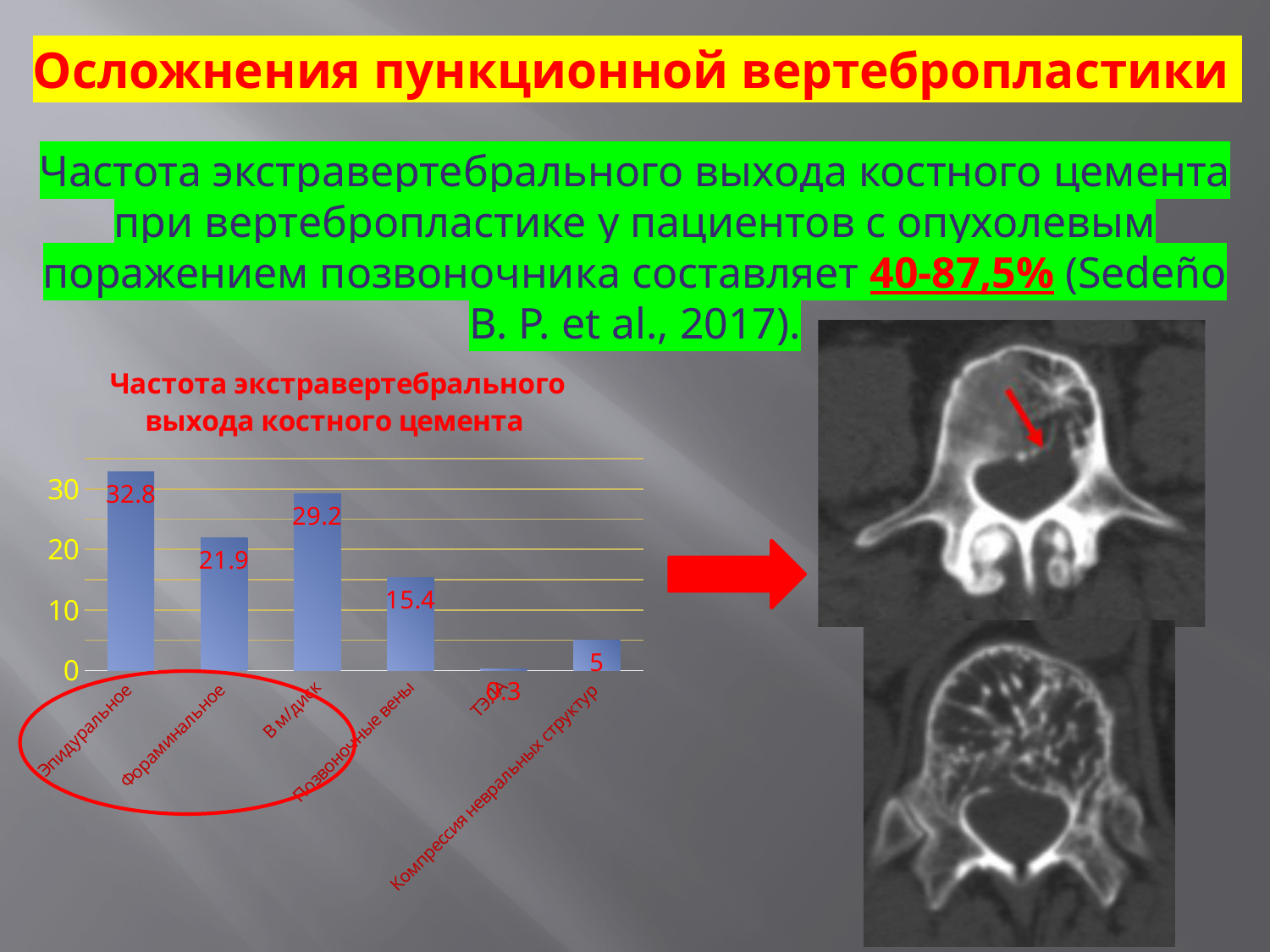
Which is larger, the value for В м/диск or the value for Позвоночные вены? В м/диск What is the value for Эпидуральное? 32.8 What is the value for Компрессия невральных структур? 5 What is the value for В м/диск? 29.2 What is the value for Фораминальное? 21.9 What is the difference between the values for Эпидуральное and Фораминальное? 10.9 Which category has the highest value? Эпидуральное What is the value for Позвоночные вены? 15.4 Which category has the lowest value? ТЭЛА What type of chart is shown on the slide? bar chart How many categories are plotted in the chart? 6 What is the title of the chart? Частота экстравертебрального выхода костного цемента